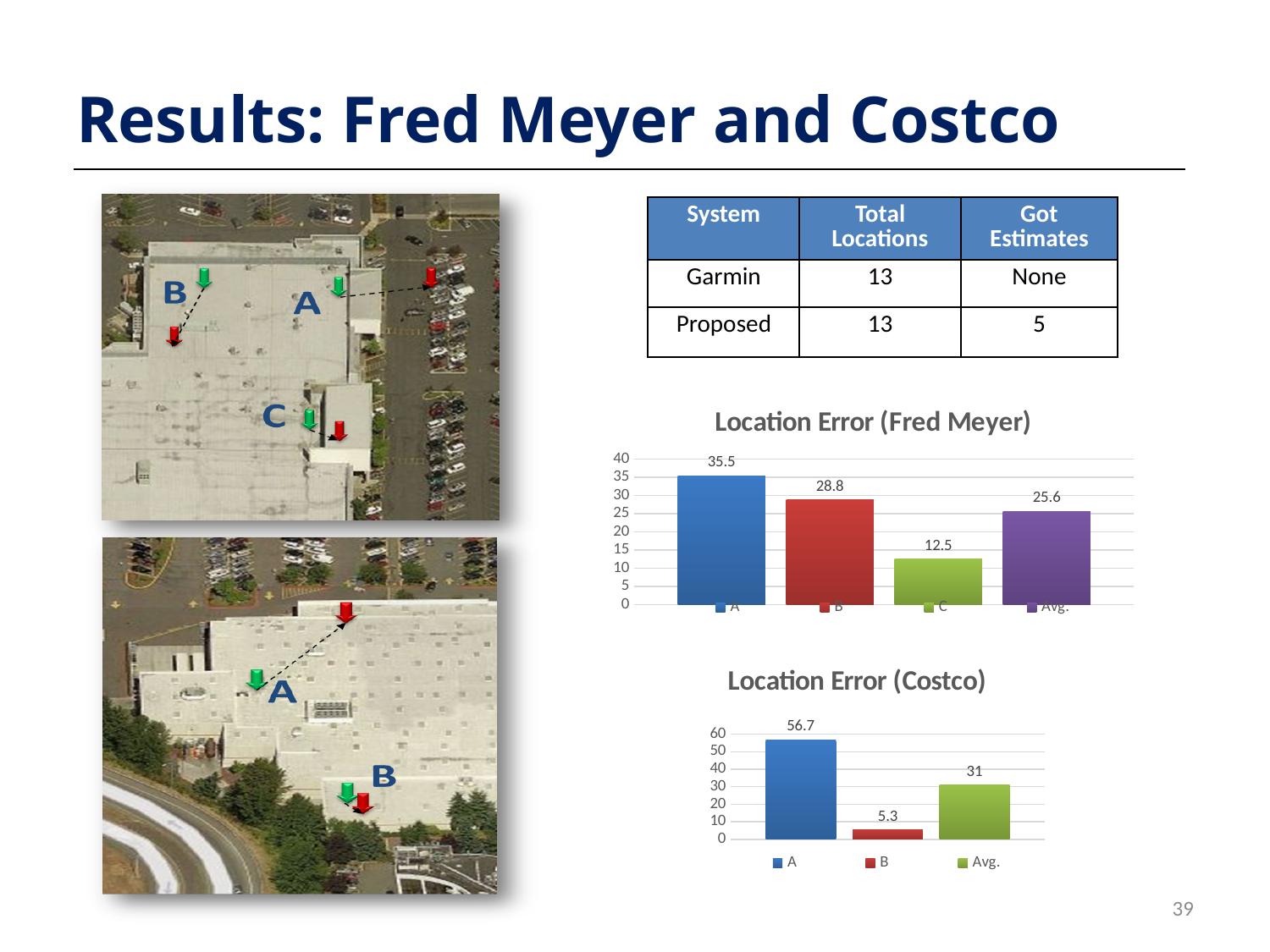
In the Location Error (Fred Meyer) chart, what is the difference between the values for A and B? 6.7 In the Location Error (Costco) chart, what is the difference between the values for A and B? 51.4 In the Location Error (Costco) chart, what is the value for Avg.? 31 In the Location Error (Fred Meyer) chart, what is the value for C? 12.5 In the Location Error (Fred Meyer) chart, how many bars are plotted? 4 In the Location Error (Costco) chart, how many entries does the legend list? 3 In the Location Error (Costco) chart, what is the value for B? 5.3 In the Location Error (Costco) chart, which category has the highest value? A What type of chart is the Location Error (Costco) chart? Bar chart In the Location Error (Fred Meyer) chart, which category has the lowest value? C In the Location Error (Fred Meyer) chart, what is the value for A? 35.5 In the Location Error (Fred Meyer) chart, which category has the highest value? A